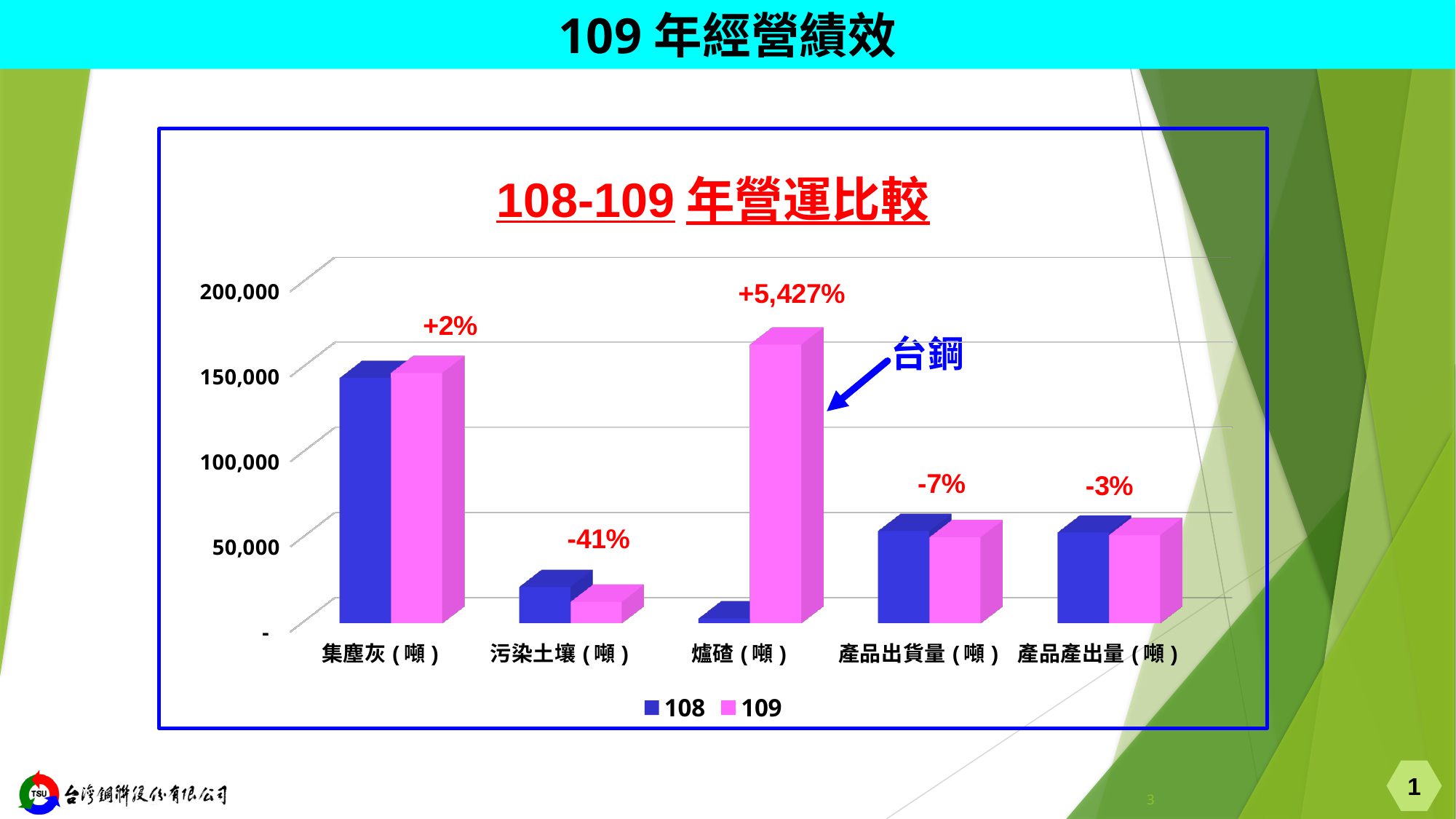
Which category has the lowest value for the 108 series? 爐碴 ( 噸 ) Which category has the highest value for the 109 series? 爐碴 ( 噸 ) What percentage change is labelled above the 污染土壤 ( 噸 ) bars? -41% What kind of chart is shown on the slide? bar chart What is the title of the chart? 108-109 年營運比較 How many categories are shown on the x axis of the chart? 5 What percentage change is labelled above the 爐碴 ( 噸 ) bars? +5,427% What percentage change is labelled above the 產品出貨量 ( 噸 ) bars? -7% Is the 109 value for 爐碴 ( 噸 ) greater or less than 150,000? greater What are the two series named in the legend? 108 and 109 How many series does the chart legend list? 2 For the 108 series, which is larger: 集塵灰 ( 噸 ) or 爐碴 ( 噸 )? 集塵灰 ( 噸 )